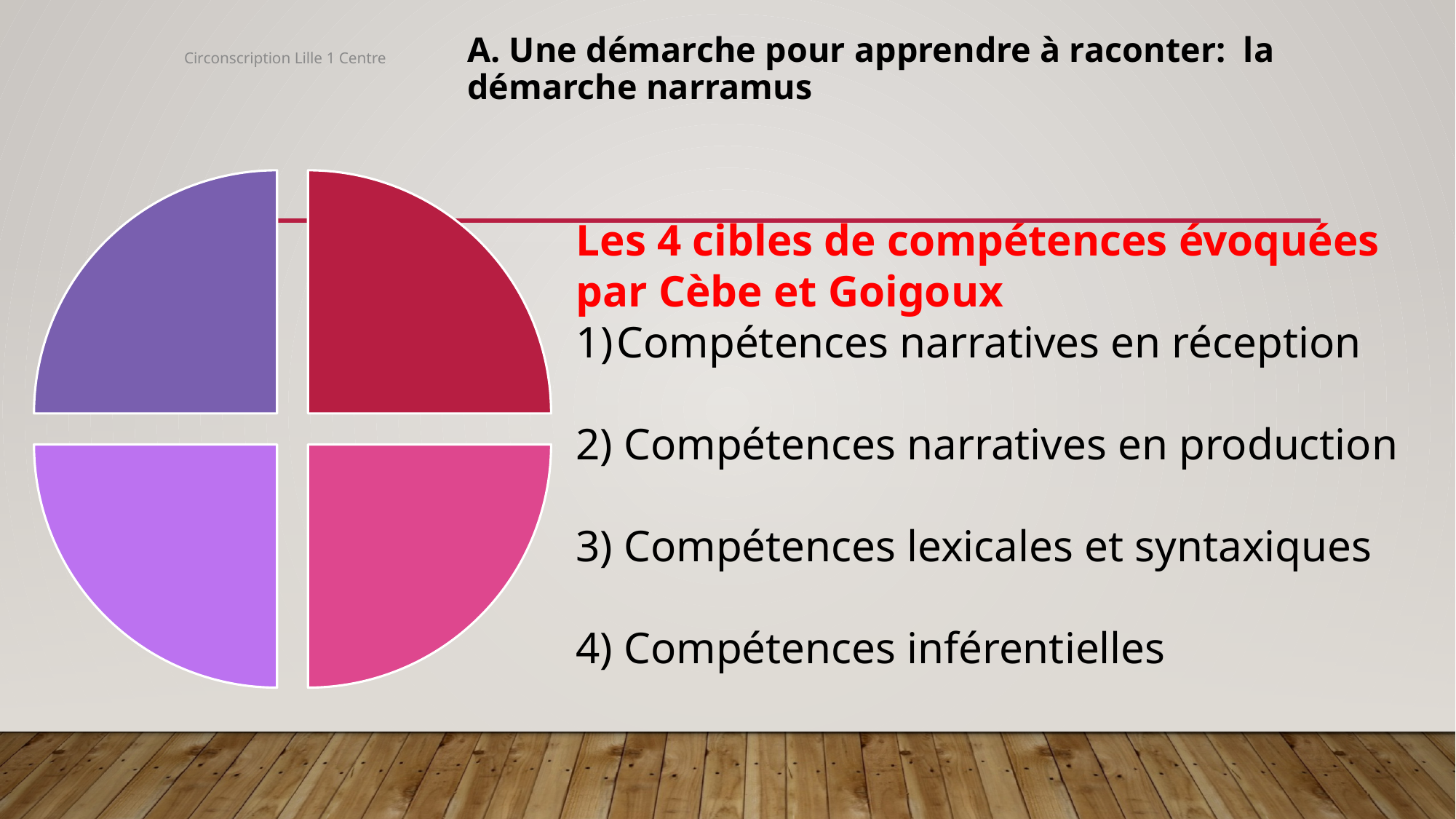
What colour is the top-right slice of the pie chart on the left of the slide? dark red Are the four slices of the pie chart on the left of the slide equal in size? yes What kind of chart is shown on the left of the slide? pie chart Does the pie chart on the left of the slide show a legend? no How many slices does the pie chart on the left of the slide have? 4